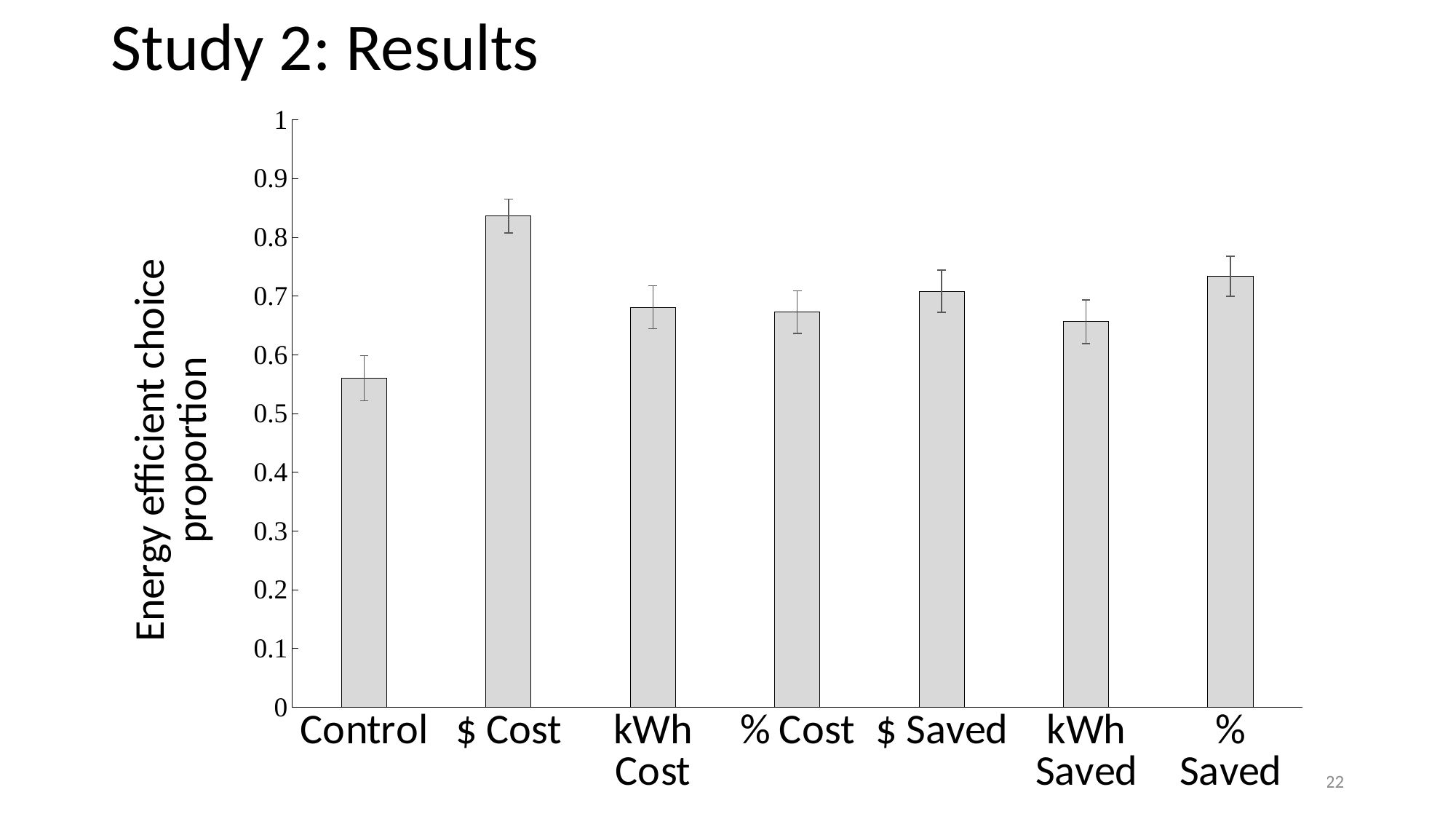
Which is larger, the value for $ Cost or the value for % Saved? $ Cost What kind of chart is shown on the slide? bar chart What is the label on the y axis? Energy efficient choice proportion Which category has the highest energy efficient choice proportion? $ Cost Which category has the lowest energy efficient choice proportion? Control How many categories are plotted on the x axis? 7 What is the title of the slide? Study 2: Results Is the value for % Saved greater or less than 0.7? greater Is the value for kWh Saved greater or less than 0.7? less Is the value for $ Cost greater or less than 0.8? greater Which is larger, the value for Control or the value for $ Cost? $ Cost